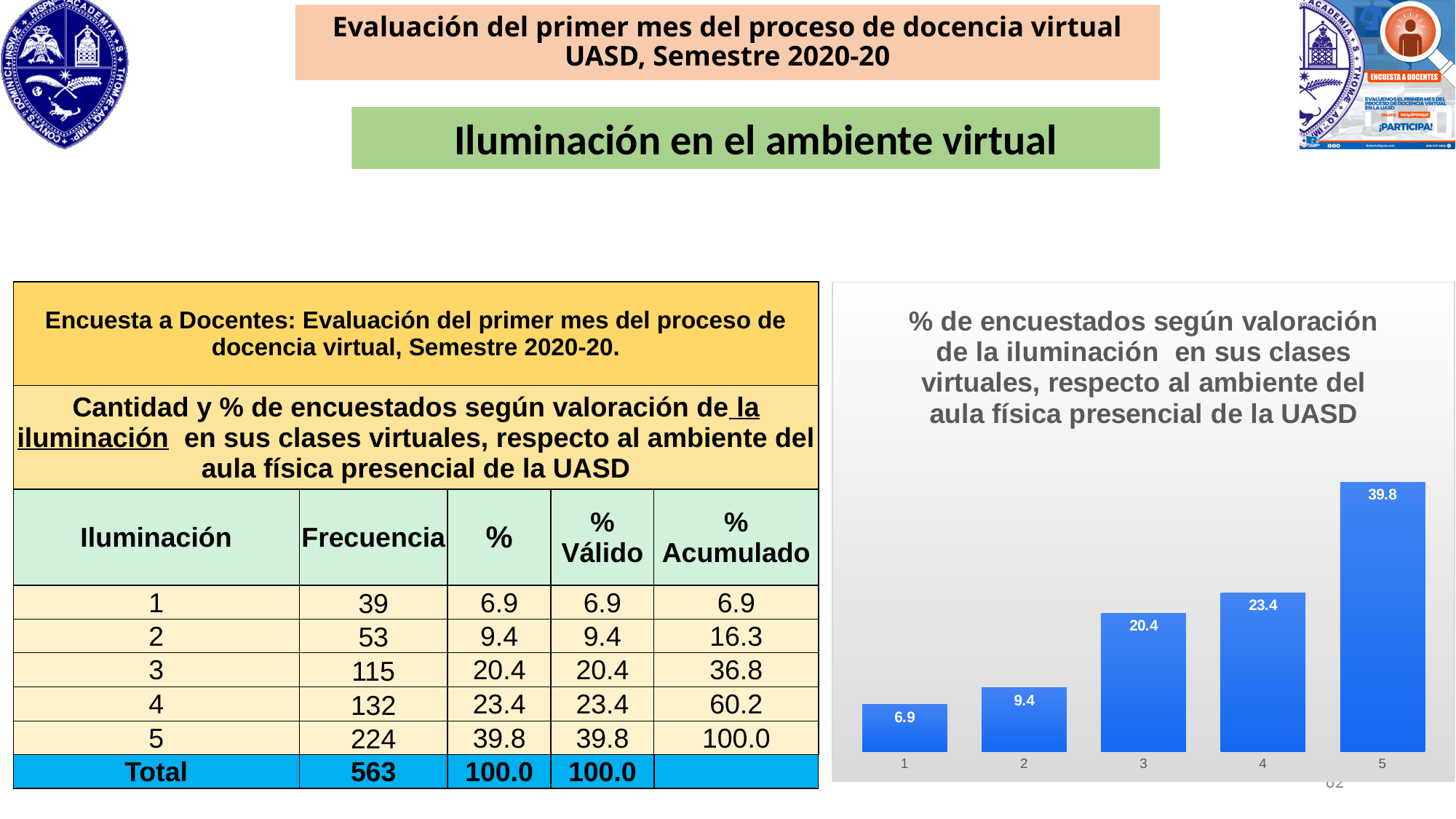
What is the value for category 3 in the bar chart? 20.4 What is the value for category 1 in the bar chart? 6.9 Which is larger in the bar chart, the value for category 3 or category 4? 4 What kind of chart is shown on the slide? bar chart What is the title of the bar chart? % de encuestados según valoración de la iluminación en sus clases virtuales, respecto al ambiente del aula física presencial de la UASD What is the value for category 5 in the bar chart? 39.8 What is the difference between the values for category 5 and category 4 in the bar chart? 16.4 Do the values in the bar chart rise or fall from category 1 to category 5? rise What is the difference between the values for category 2 and category 1 in the bar chart? 2.5 How many categories are shown on the x axis of the bar chart? 5 Which category has the highest value in the bar chart? 5 Which category has the lowest value in the bar chart? 1